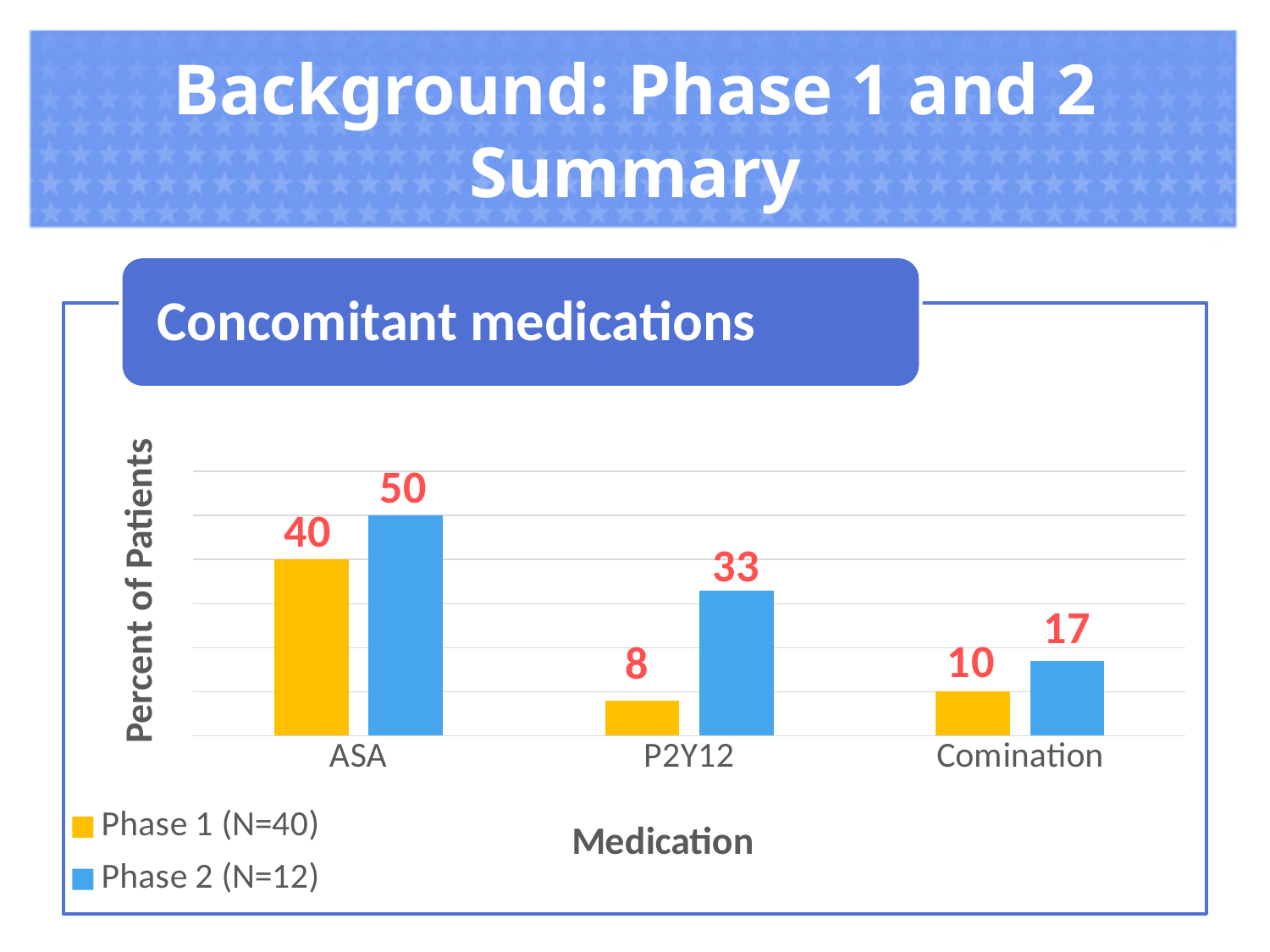
What is the Phase 2 (N=12) value for P2Y12? 33 What is the Phase 1 (N=40) value for ASA? 40 How many series does the legend list? 2 Which medication has the lowest Phase 1 (N=40) value? P2Y12 What is the Phase 1 (N=40) value for Comination? 10 What is the difference between the Phase 2 (N=12) and Phase 1 (N=40) values for P2Y12? 25 Which is larger for Comination: the Phase 1 (N=40) value or the Phase 2 (N=12) value? Phase 2 (N=12) What is the label of the y axis? Percent of Patients Which medication has the highest Phase 2 (N=12) value? ASA What kind of chart is shown? bar chart How many medication categories are shown on the x axis? 3 What is the title of the chart? Concomitant medications